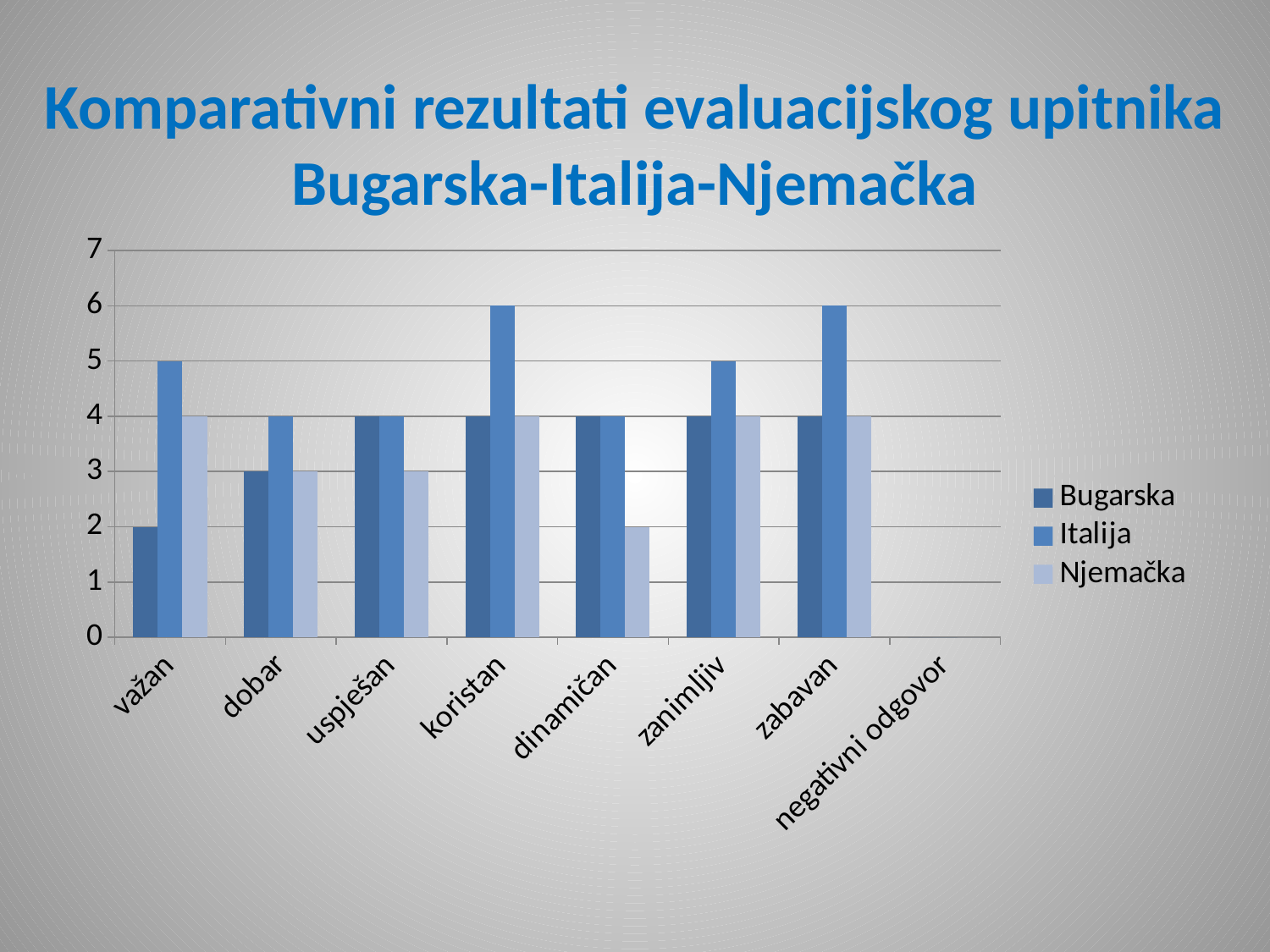
Is the value for Italija in the category zanimljiv greater or less than 4? greater What is the value for Bugarska in the category važan? 2 How many categories are shown on the x axis? 8 How many series does the legend list? 3 Which series has the lowest value in the category važan? Bugarska Which series has the highest value in the category zabavan? Italija What type of chart is shown on the slide? bar chart What is the value for Njemačka in the category dinamičan? 2 Which is larger in the category dobar: the value for Italija or the value for Njemačka? Italija What is the difference between the Italija and Bugarska values in the category važan? 3 What is the value for Italija in the category koristan? 6 Which series is shown in the lightest blue colour in the legend? Njemačka